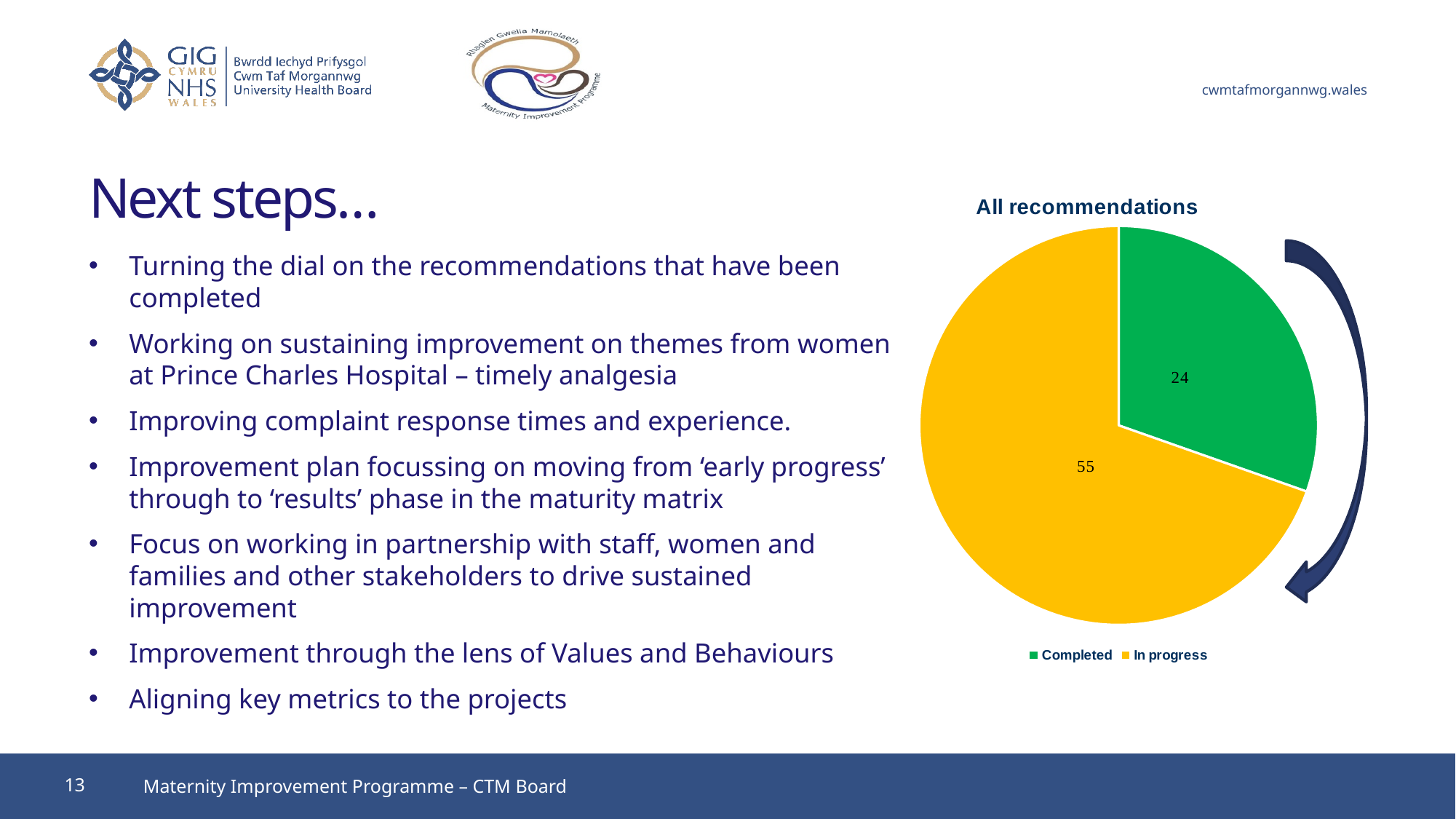
What is the difference between the In progress and Completed values? 31 Which category has the larger slice of the pie? In progress How many recommendations are shown as Completed? 24 How many entries does the legend list? 2 Which category has the smaller slice of the pie? Completed What is the title of the chart? All recommendations Which colour represents the Completed category in the pie chart? green How many slices does the pie chart have? 2 How many recommendations are shown as In progress? 55 What is the total of all recommendations shown in the pie chart? 79 Is the value for Completed larger or smaller than the value for In progress? smaller What type of chart is shown on the slide? pie chart